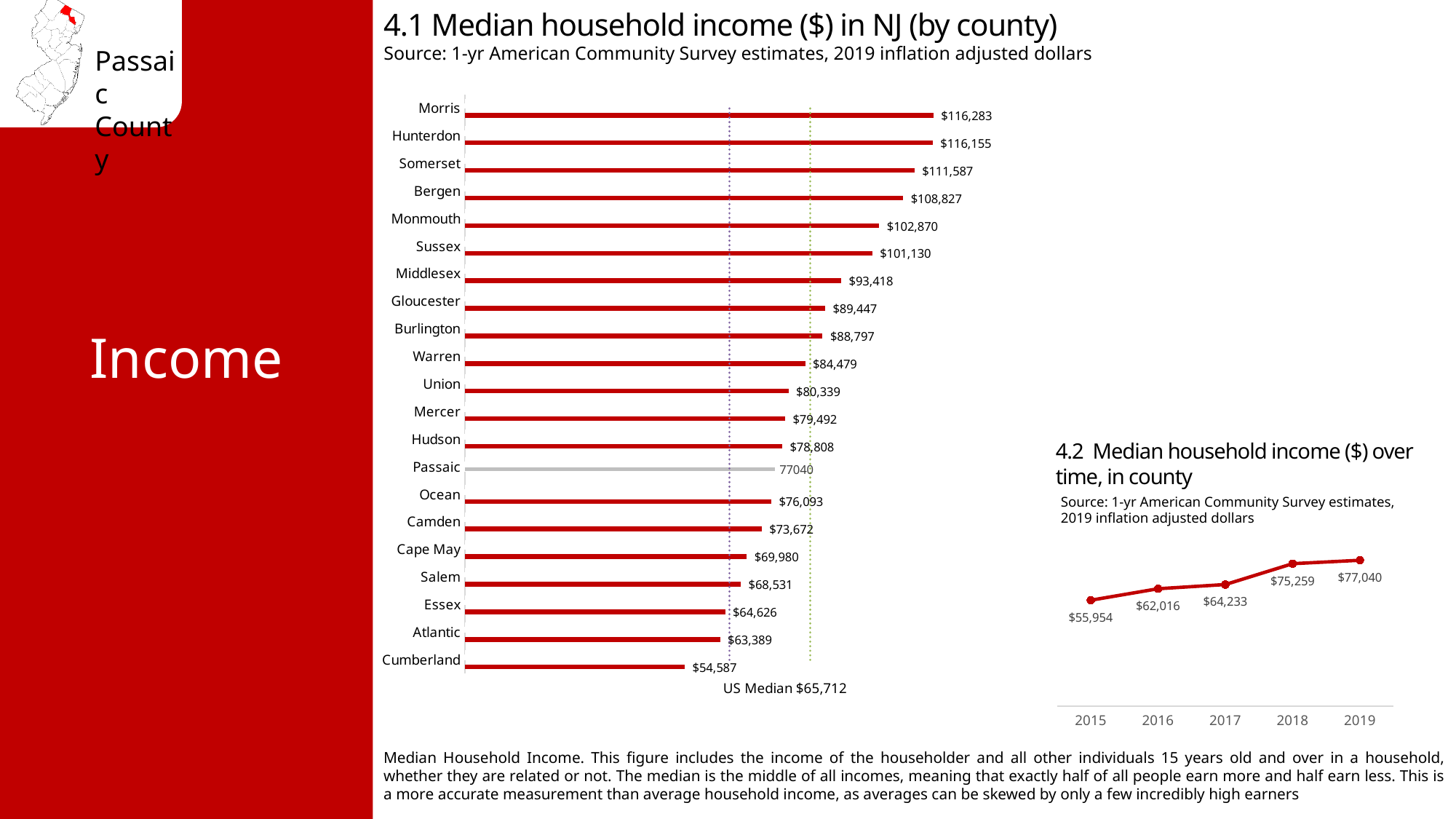
In chart 4.1, what is the median household income for Passaic? 77040 In chart 4.2, what is the difference between the median household income in 2019 and in 2015? $21,086 In chart 4.1, which county has the highest median household income? Morris In chart 4.1, which county has the lowest median household income? Cumberland In chart 4.2, does the median household income rise or fall from 2015 to 2019? Rise In chart 4.1, which county has a higher median household income, Gloucester or Burlington? Gloucester In chart 4.2 (Median household income over time, in county), what was the median household income in 2016? $62,016 In chart 4.1, how many counties are shown? 21 In chart 4.1, what is the difference between the median household income of Morris and Hunterdon? $128 In chart 4.1 (Median household income in NJ by county), what is the median household income for Bergen? $108,827 What kind of chart is chart 4.1? Bar chart In chart 4.1, what US median value is noted below the bars? $65,712